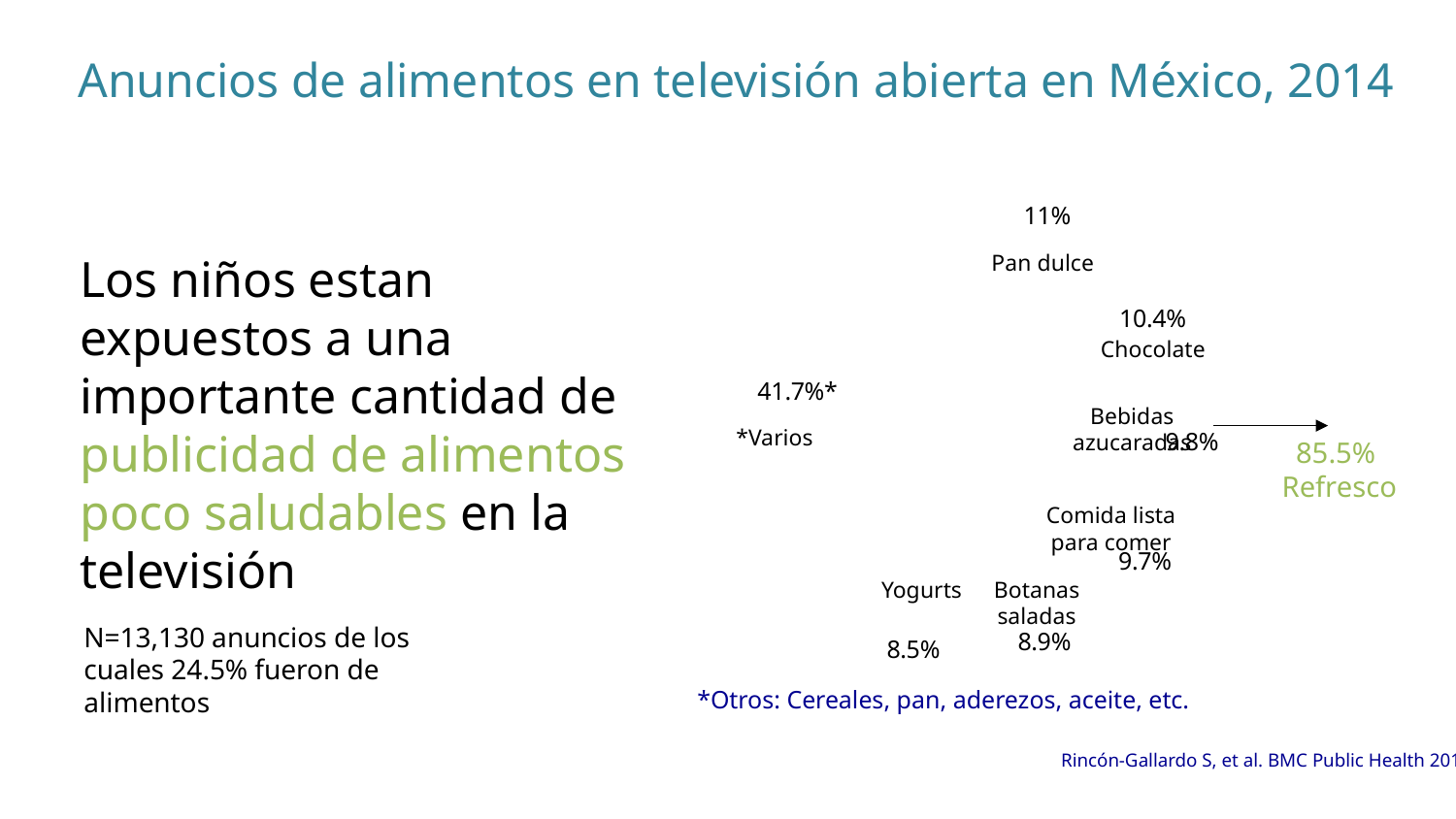
What percentage is shown for Botanas saladas? 8.9% What value is shown for Yogurts? 8.5% What percentage of food advertisements is labelled for Pan dulce? 11% Which is larger, the share for Botanas saladas or for Yogurts? Botanas saladas What is the difference between the Pan dulce and Chocolate shares? 0.6 percentage points How many categories are labelled in the chart? 7 What percentage is shown for Bebidas azucaradas? 9.8% According to the annotation, what percentage of Bebidas azucaradas is Refresco? 85.5% What value is shown for Chocolate? 10.4% Which category has the largest share in the chart? *Varios (41.7%) Which labelled category has the smallest share? Yogurts (8.5%) What value is shown for Comida lista para comer? 9.7%